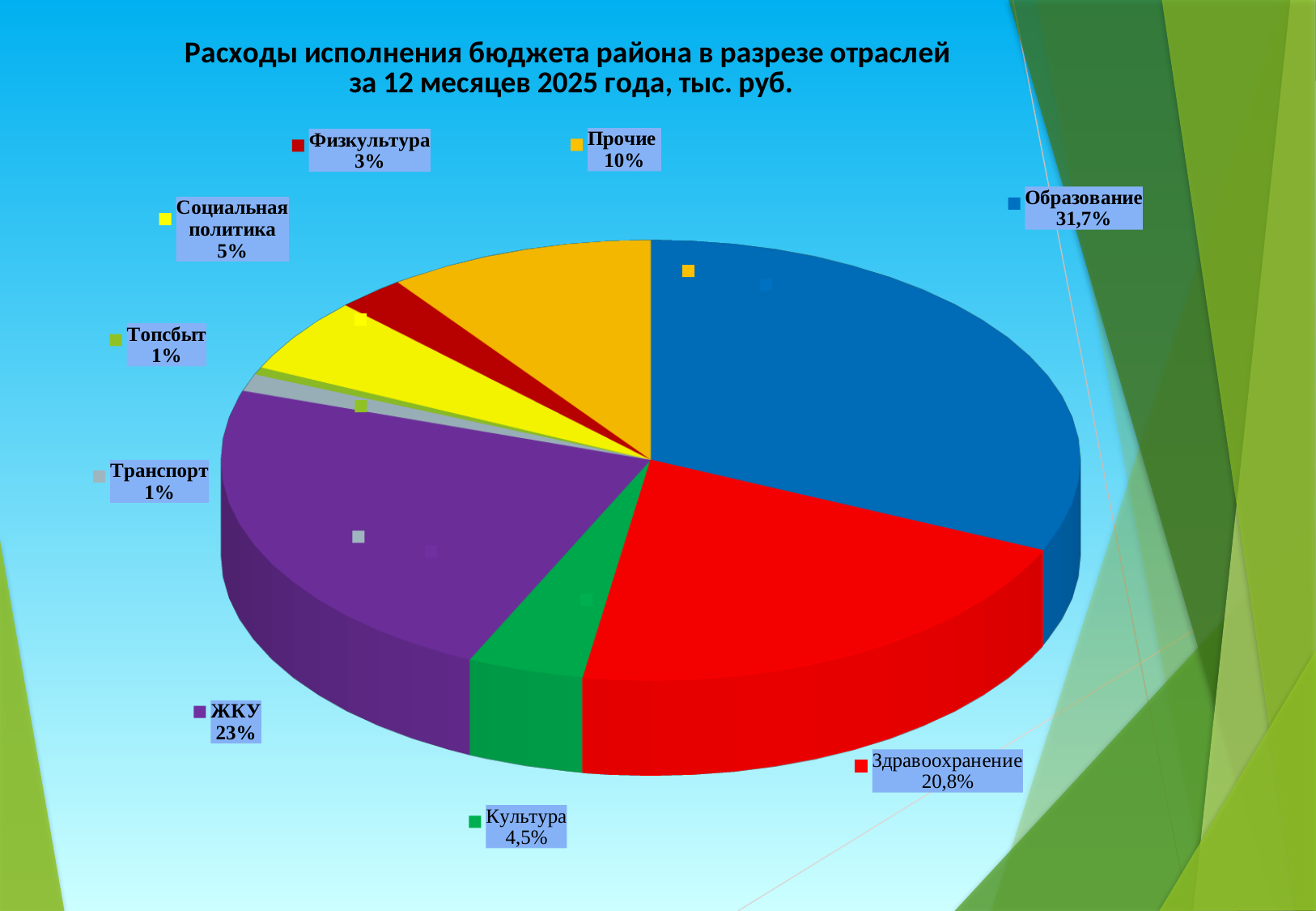
Which is larger, the share for ЖКУ or the share for Здравоохранение? ЖКУ What share of the budget expenditure goes to Образование? 31,7% What kind of chart is shown on the slide? pie chart What share is shown for Культура? 4,5% What share is shown for Прочие? 10% How many sectors (slices) are shown in the pie chart? 9 What share is shown for ЖКУ? 23% What is the title of the chart? Расходы исполнения бюджета района в разрезе отраслей за 12 месяцев 2025 года, тыс. руб. Which sector has the largest share of the budget expenditure? Образование What share is shown for Здравоохранение? 20,8% What share is shown for Социальная политика? 5% By how many percentage points does the share for Образование exceed the share for Здравоохранение? 10,9